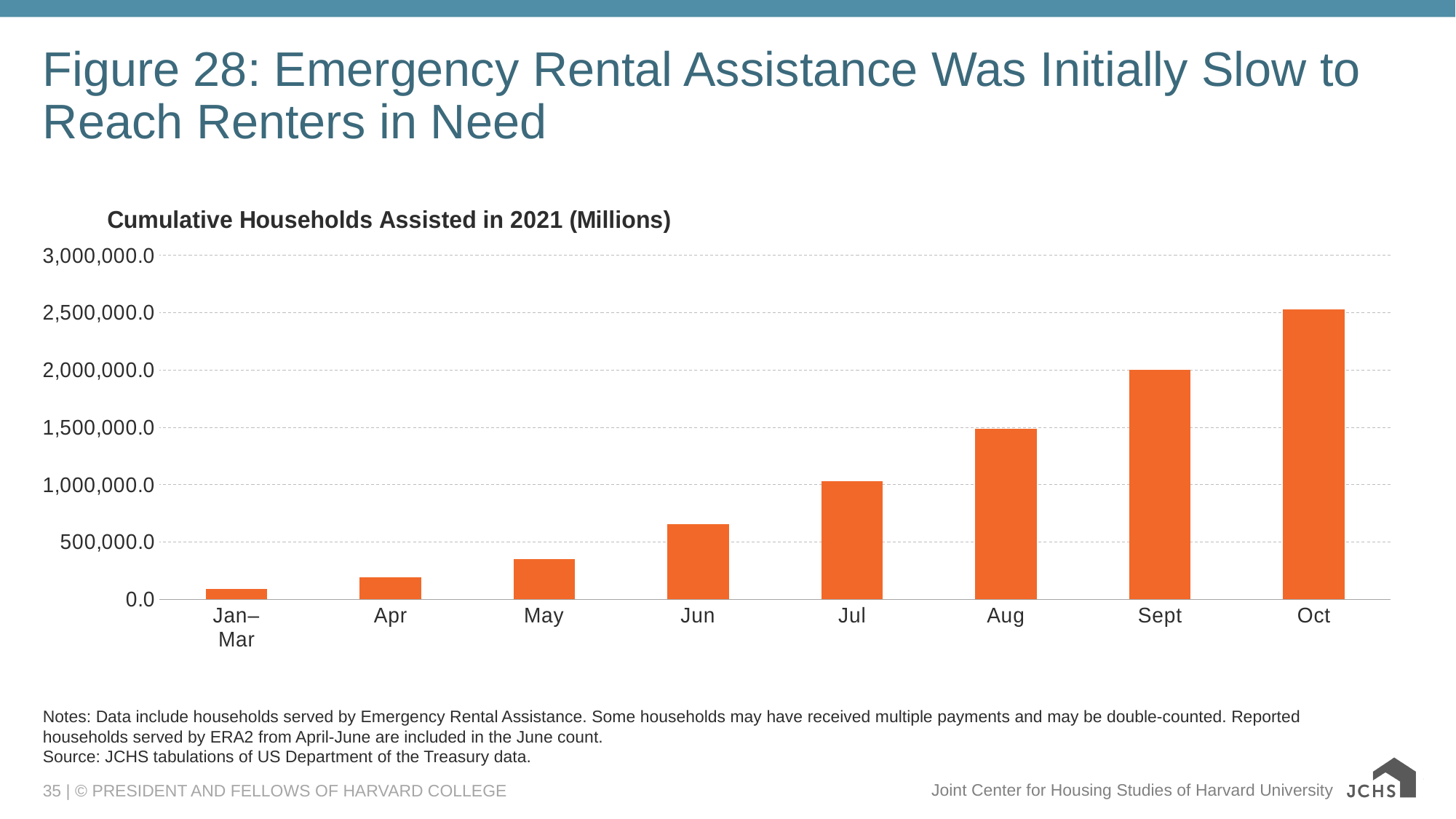
Is the value for May greater or less than 500,000.0? less Which is larger, the value for Jul or the value for Jun? Jul Do the values rise or fall from Jan–Mar to Oct? rise Is the value for Jun greater or less than 500,000.0? greater Which period has the highest cumulative households assisted? Oct How many categories (time periods) are shown on the x axis? 8 Which period has the lowest cumulative households assisted? Jan–Mar What is the title of the chart? Cumulative Households Assisted in 2021 (Millions) What type of chart is shown on the slide? bar chart